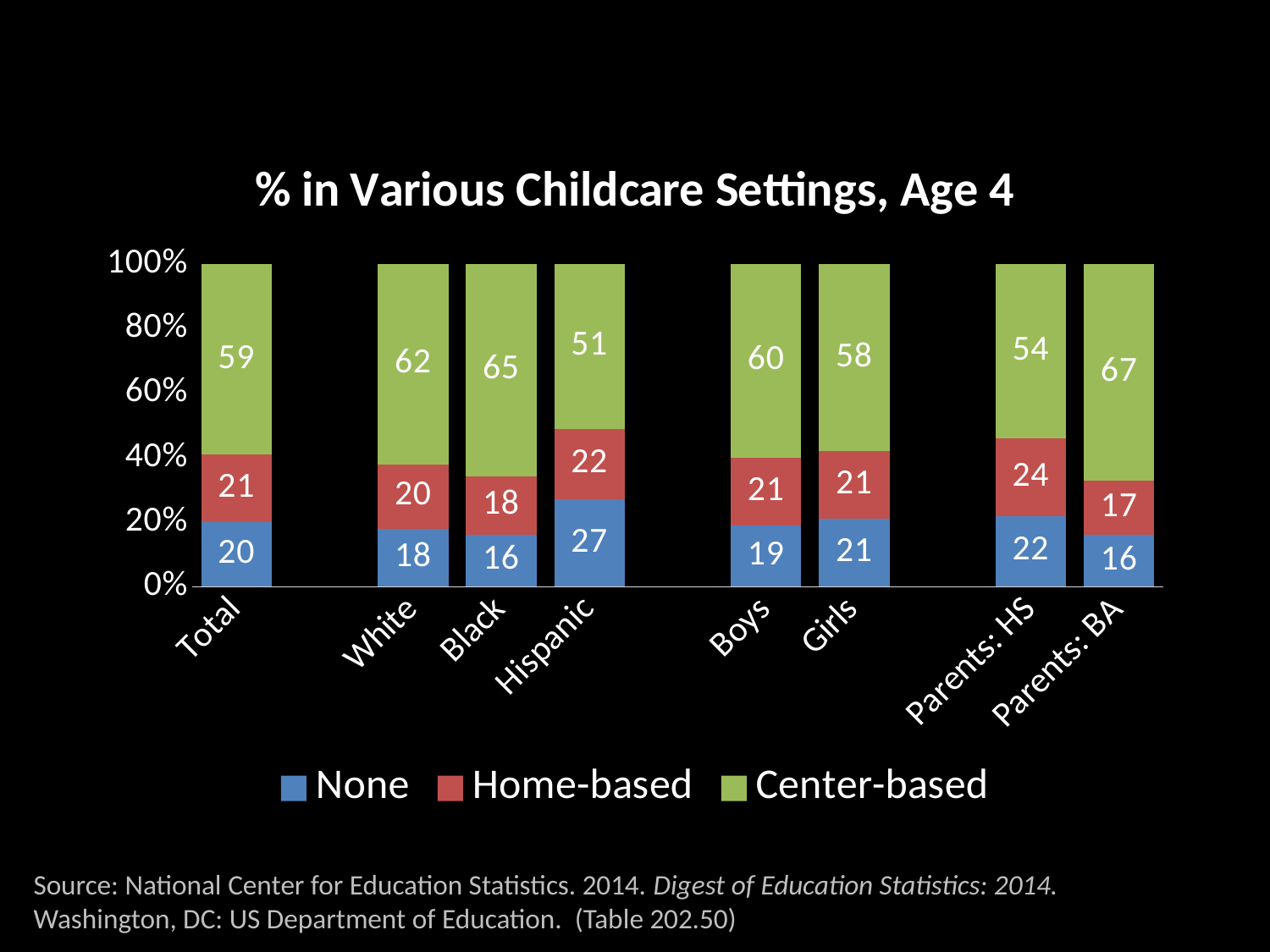
What kind of chart is shown on the slide? Stacked bar chart How many categories are shown on the x axis? 8 Which category has the highest Center-based value? Parents: BA What is the value for Home-based childcare for the Parents: HS category? 24 Which category has the lowest Center-based value? Hispanic How much higher is the Center-based value for Parents: BA than for Parents: HS? 13 What is the difference between the None values for Hispanic and Black children? 11 What percentage of 4-year-olds in the Total category are in center-based childcare? 59 Which category has the highest value for None? Hispanic How many series does the legend list? 3 Which has a larger Center-based value, White or Black? Black What is the value for None (no childcare setting) for Hispanic children? 27